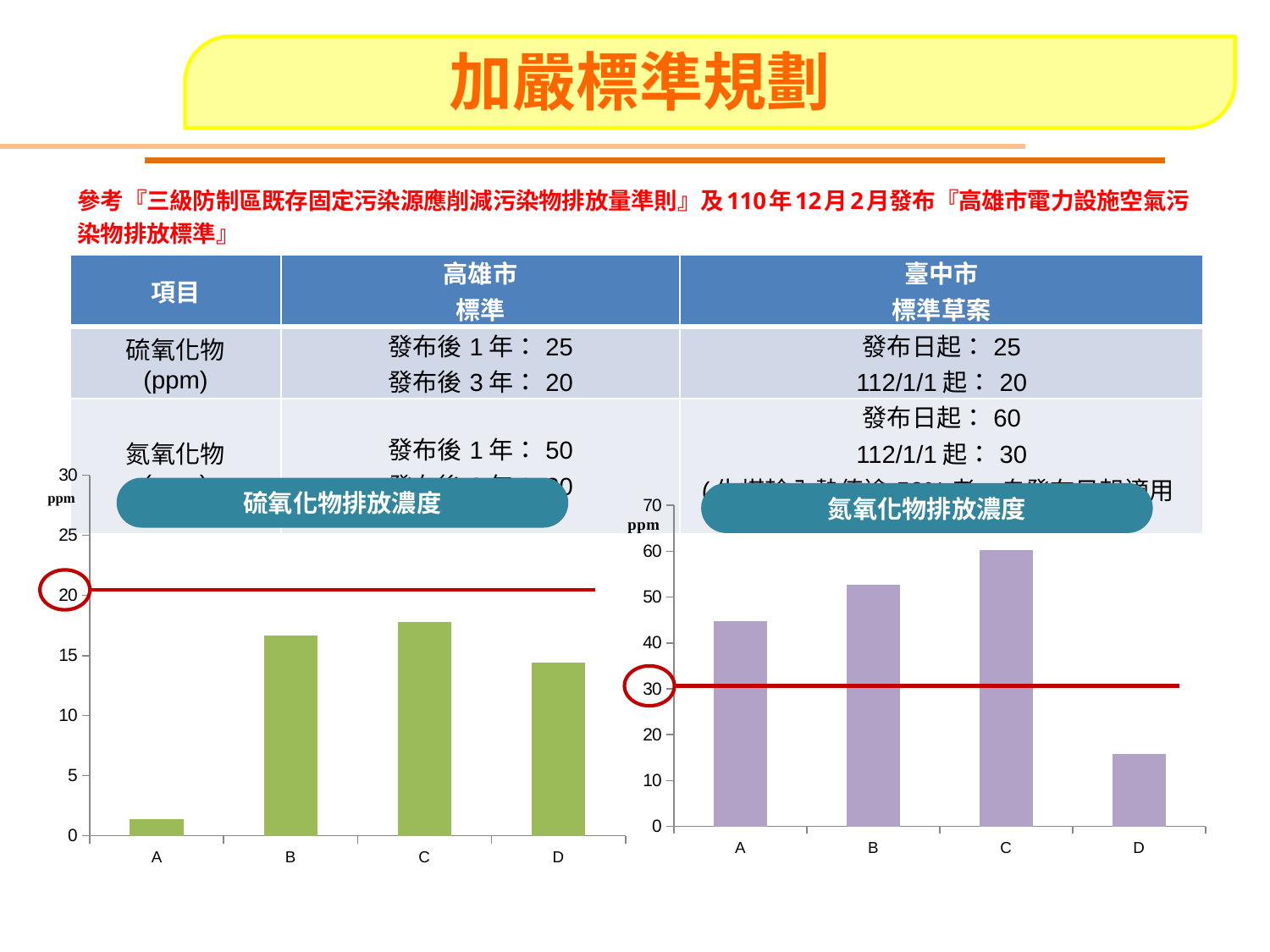
At what value on the y axis is the red horizontal line drawn in the 氮氧化物排放濃度 chart? 30 In the 硫氧化物排放濃度 chart, is the value for B greater or less than 15? greater In the 氮氧化物排放濃度 chart, which category has the lowest value? D In the 硫氧化物排放濃度 chart, is the value for C greater or less than 20? less In the 硫氧化物排放濃度 chart, is the value for A greater or less than 5? less In the 硫氧化物排放濃度 chart, which category has the lowest value? A In the 硫氧化物排放濃度 chart, which is larger, the value for C or the value for D? C How many categories are shown on the x axis of the 硫氧化物排放濃度 chart? 4 In the 氮氧化物排放濃度 chart on the right, which category has the highest value? C What kind of chart is the 硫氧化物排放濃度 chart on the left? bar chart